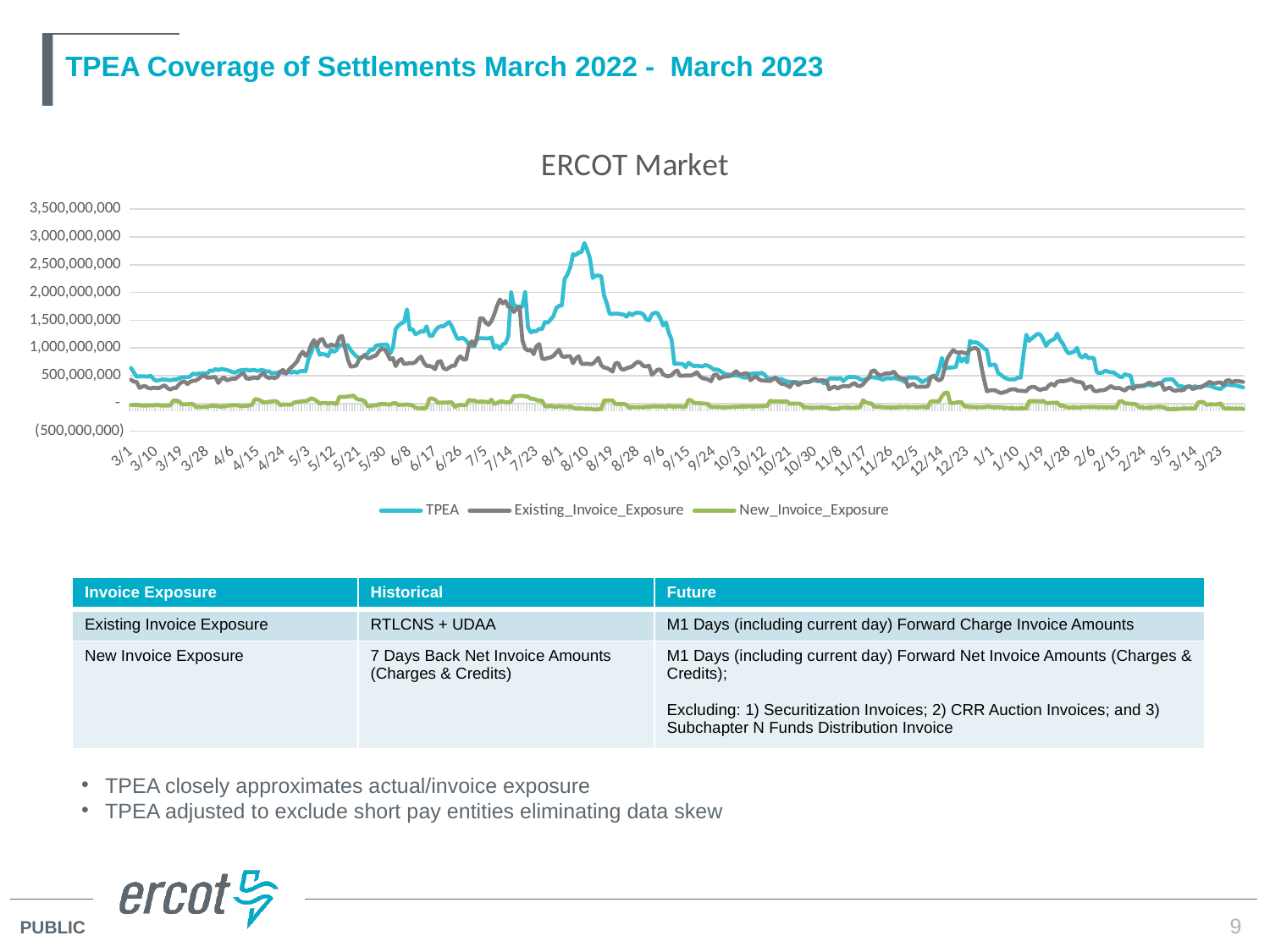
What is the highest value shown on the y axis of the ERCOT Market chart? 3,500,000,000 Which series stays lowest throughout the ERCOT Market chart? New_Invoice_Exposure Is the value of Existing_Invoice_Exposure on 7/14 greater or less than 1,500,000,000? greater Is the peak value of TPEA around 8/10 greater or less than 2,500,000,000? greater Is the value of New_Invoice_Exposure on 8/10 greater or less than 500,000,000? less Which series reaches the highest peak in the ERCOT Market chart? TPEA Does the TPEA line rise or fall between 8/10 and 9/24? Fall How many series does the legend of the ERCOT Market chart list? 3 Around 8/10, which series is larger: TPEA or Existing_Invoice_Exposure? TPEA What kind of chart is shown on the slide? Line chart Which series is drawn in green in the ERCOT Market chart? New_Invoice_Exposure What is the title of the chart? ERCOT Market